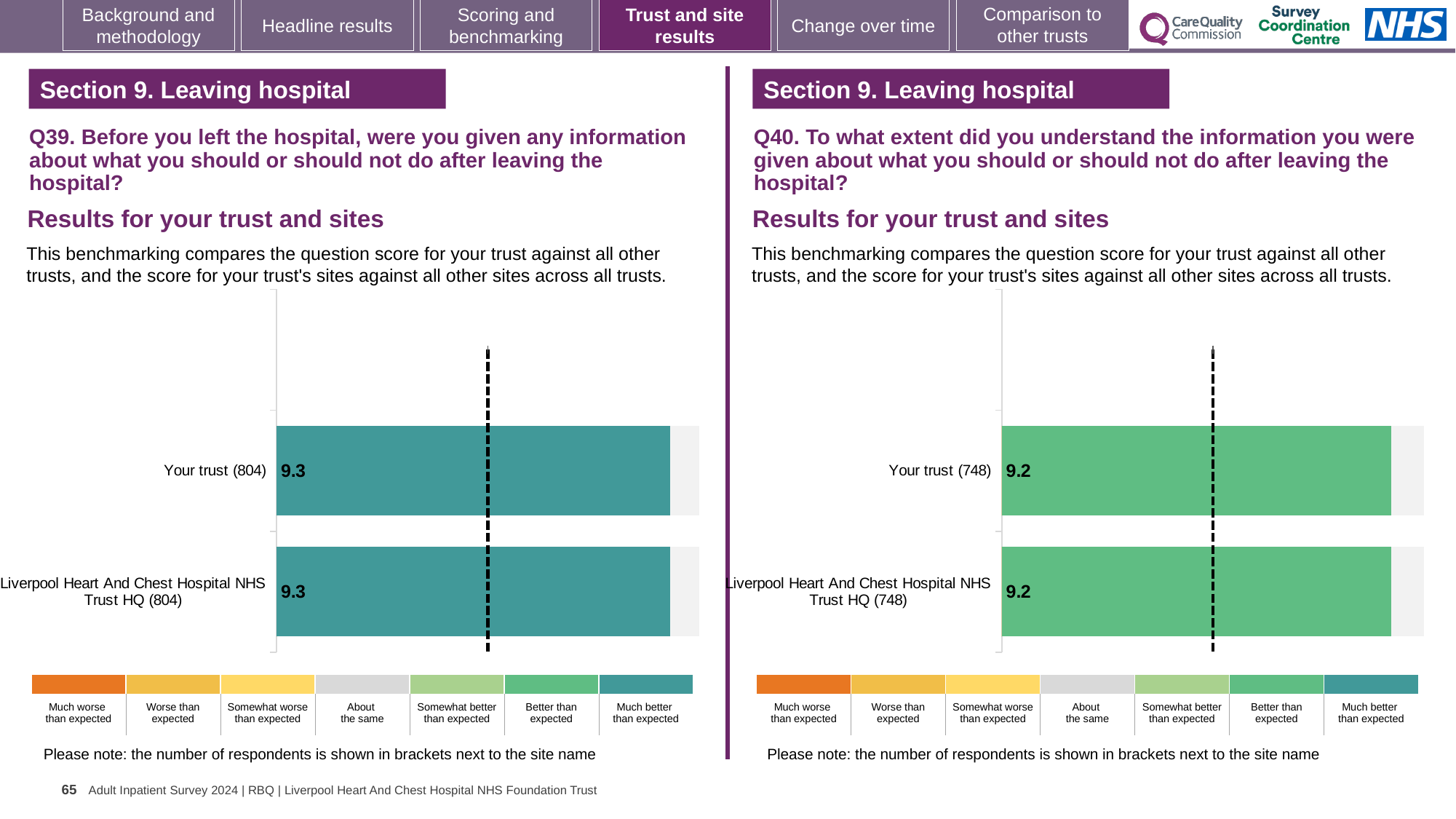
In the Q40 chart on the right, how many respondents are shown in brackets for Liverpool Heart And Chest Hospital NHS Trust HQ? 748 In the Q39 chart on the left, what is the score for Your trust? 9.3 In the Q40 chart on the right, what is the score for Liverpool Heart And Chest Hospital NHS Trust HQ? 9.2 In the Q39 chart on the left, what is the score for Liverpool Heart And Chest Hospital NHS Trust HQ? 9.3 What kind of chart is the Q39 chart on the left? Bar chart In the Q40 chart on the right, what is the score for Your trust? 9.2 How many bars are plotted in the Q39 chart on the left? 2 In the Q39 chart on the left, what is the difference between the score for Your trust and the score for Liverpool Heart And Chest Hospital NHS Trust HQ? 0 In the Q39 chart on the left, how many respondents are shown in brackets for Your trust? 804 In the Q40 chart on the right, what is the difference between the score for Your trust and the score for Liverpool Heart And Chest Hospital NHS Trust HQ? 0 How many bars are plotted in the Q40 chart on the right? 2 According to the colour key, which benchmark category do the bars in the Q40 chart on the right fall into? Better than expected